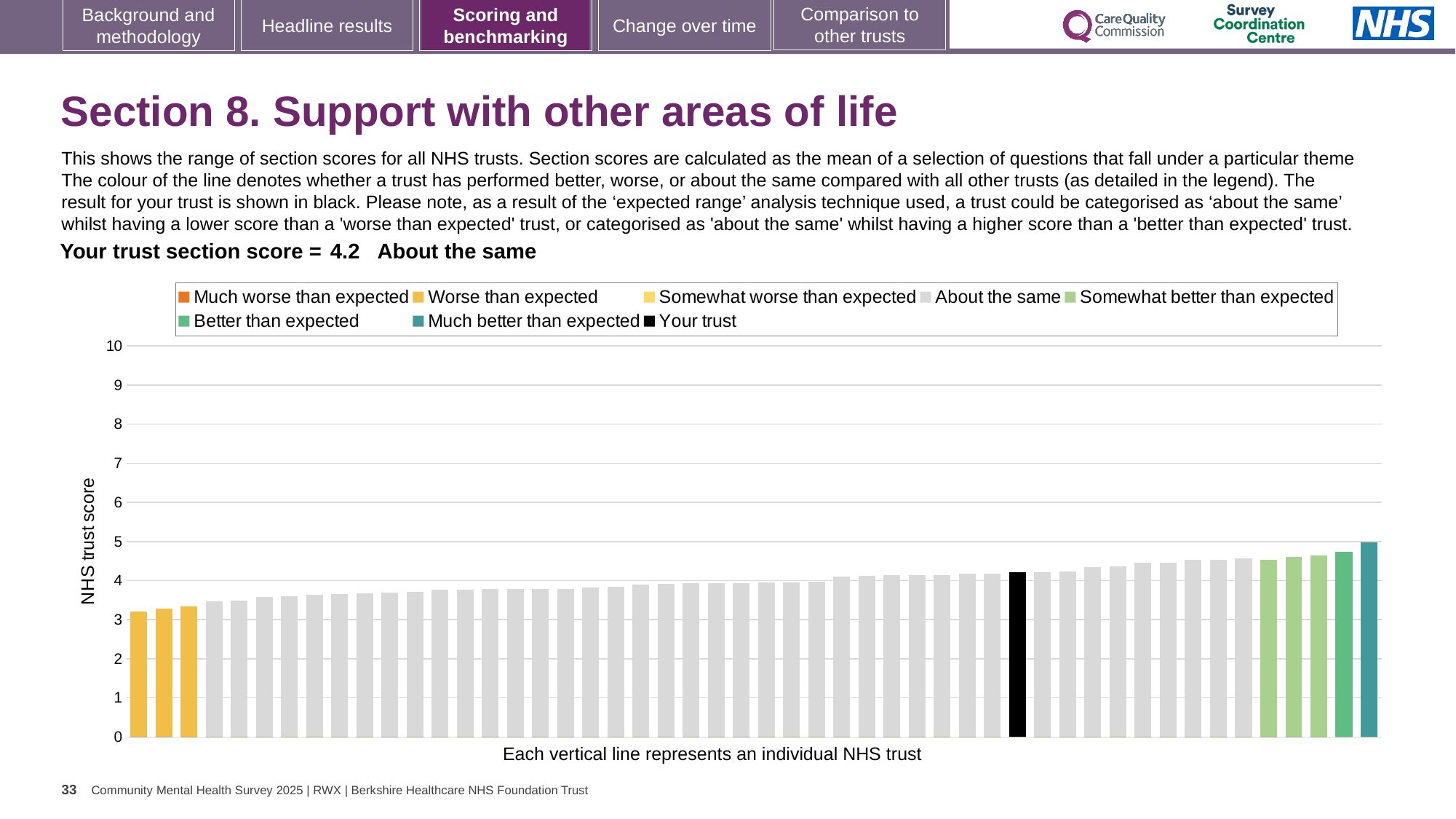
Do the bar values rise or fall from left to right along the x axis? rise What is the section score for your trust shown on the slide? 4.2 How many entries does the chart legend list? 8 Which category is your trust's section score placed in? About the same Which legend category does the highest bar belong to? Much better than expected How many bars are coloured as 'Worse than expected'? 3 Is the value of the lowest bar greater or less than 4? less What kind of chart is shown on the slide? bar chart Which legend category do the lowest bars belong to? Worse than expected Is the value of the highest bar greater or less than 6? less Is the value for your trust (the black bar) greater or less than 4? greater What is the label on the y axis of the chart? NHS trust score